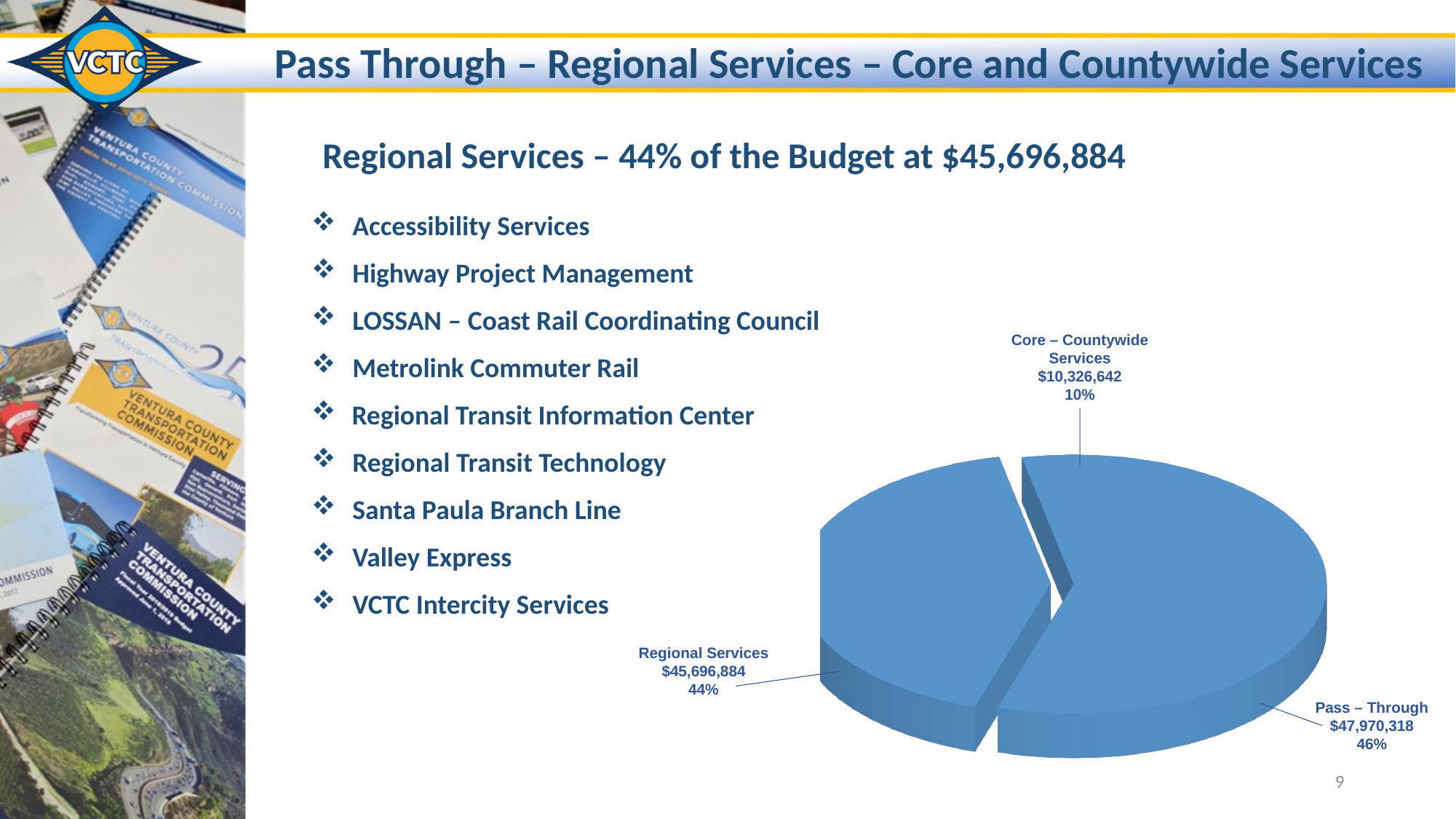
What is the dollar value of the Pass – Through slice in the pie chart? $47,970,318 What is the dollar value of the Core – Countywide Services slice in the pie chart? $10,326,642 What is the difference in dollars between the Pass – Through slice and the Regional Services slice? $2,273,434 Which is larger in the pie chart, Pass – Through or Regional Services? Pass – Through What kind of chart is shown on the slide? Pie chart How many slices does the pie chart have? 3 What share of the pie does Core – Countywide Services represent? 10% What is the dollar value of the Regional Services slice in the pie chart? $45,696,884 What share of the pie does Pass – Through represent? 46% Which slice of the pie chart is the smallest? Core – Countywide Services Which slice of the pie chart is the largest? Pass – Through What is the difference in dollars between the Regional Services slice and the Core – Countywide Services slice? $35,370,242